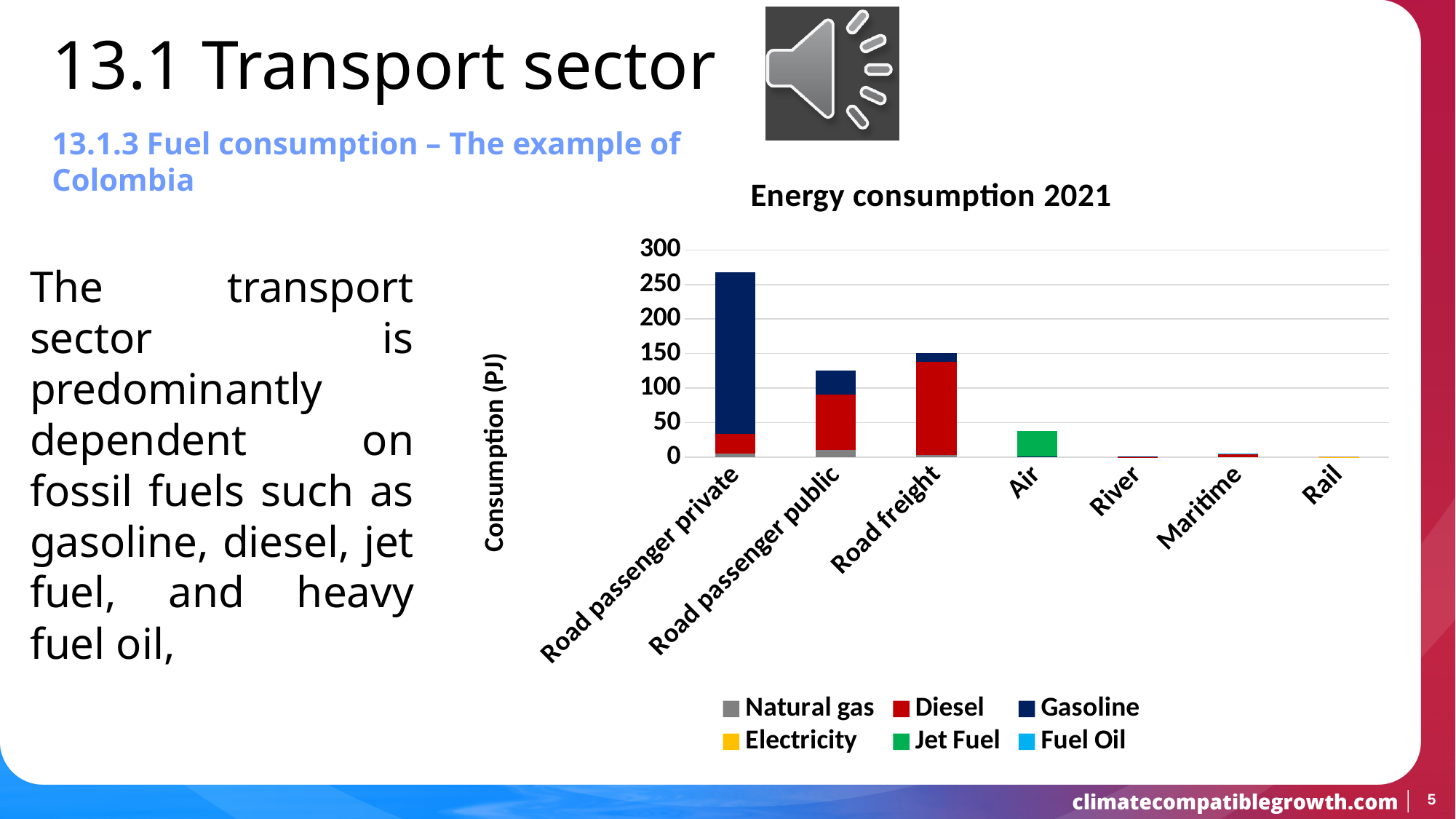
What is the title of the chart? Energy consumption 2021 Is the total value for Road passenger public greater or less than 100? greater How many transport categories are shown on the x axis of the chart? 7 Which transport category has the highest total energy consumption in the chart? Road passenger private Is the total value for Road freight greater or less than 100? greater Which has a larger total energy consumption, Road passenger private or Road freight? Road passenger private Which has a larger total energy consumption, Air or Road freight? Road freight Is the total value for Road passenger private greater or less than 250? greater What is the label of the y axis of the chart? Consumption (PJ) What type of chart is shown on the slide? Stacked bar chart How many series does the chart legend list? 6